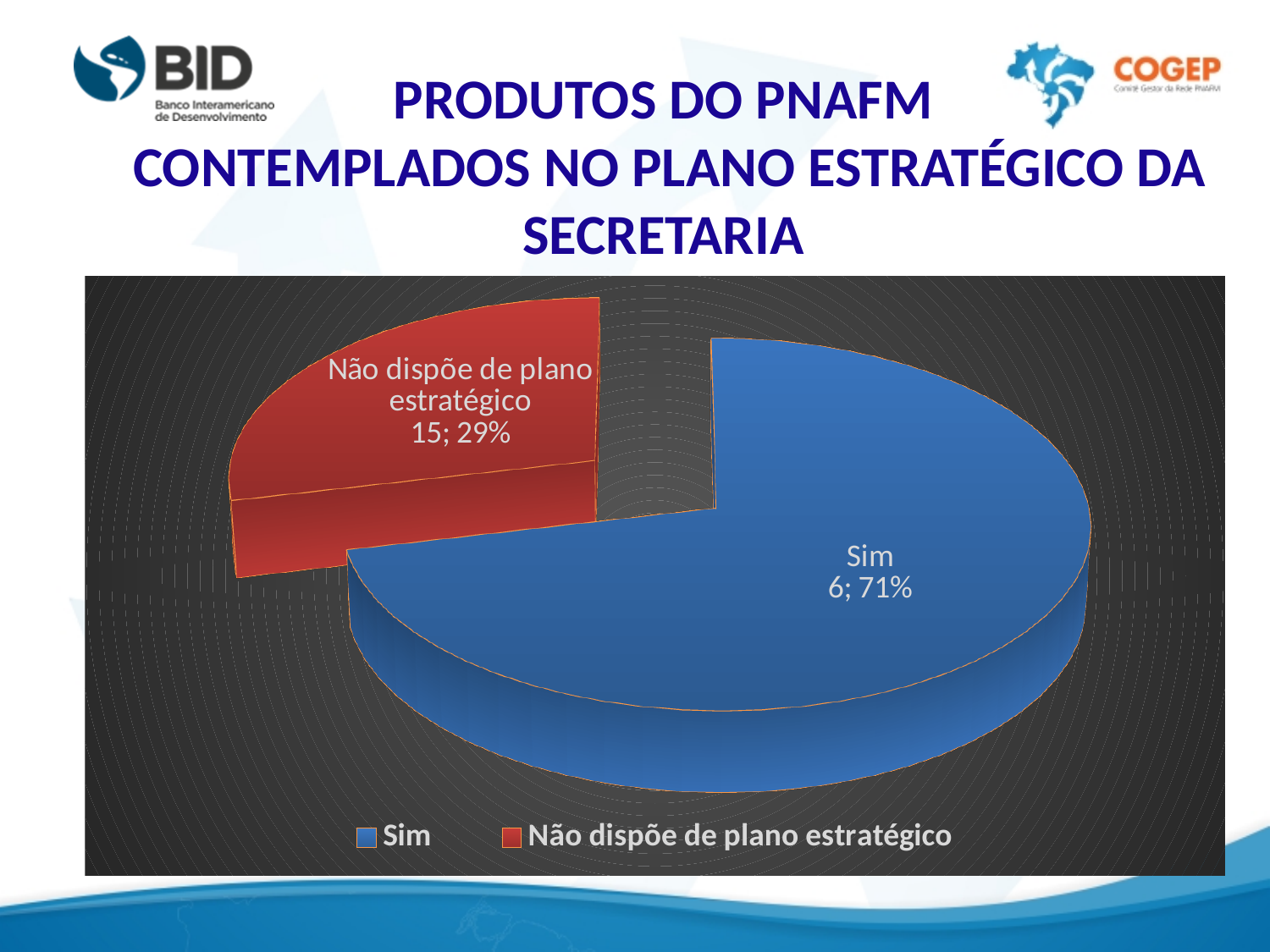
What number is printed in the data label of the 'Sim' slice, before the percentage? 6 What is the difference in percentage points between the 'Sim' slice and the 'Não dispõe de plano estratégico' slice? 42% What percentage is shown for the 'Não dispõe de plano estratégico' slice? 29% Which slice has the larger percentage share of the pie? Sim What number is printed in the data label of the 'Não dispõe de plano estratégico' slice, before the percentage? 15 How many slices does the pie chart have? 2 What kind of chart is shown on the slide? pie chart What colour is the 'Sim' slice? blue Which slice has the smaller percentage share of the pie? Não dispõe de plano estratégico What is the title of the slide containing the chart? PRODUTOS DO PNAFM CONTEMPLADOS NO PLANO ESTRATÉGICO DA SECRETARIA How many entries does the legend list? 2 What percentage is shown for the 'Sim' slice? 71%